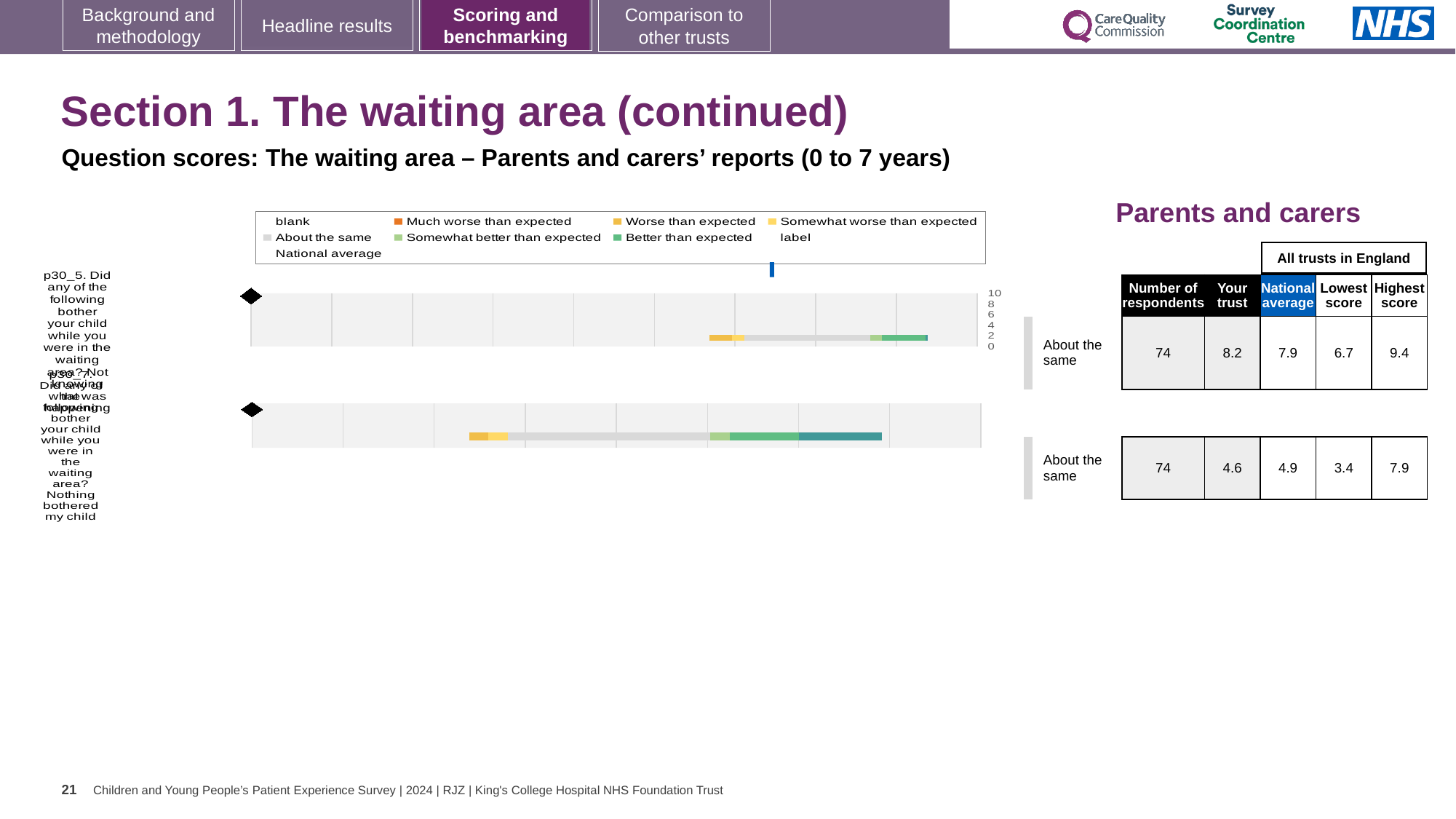
How many respondents are listed for the first question in the table? 74 In the table, what is the 'Your trust' score for the first question (p30_5, Not knowing what was happening)? 8.2 What is the lowest score across all trusts in England for the second question? 3.4 For the first question, which is higher: the 'Your trust' score or the national average? Your trust What is the difference between the highest score and the lowest score for the first question in the table? 2.7 How many entries does the chart legend list? 9 For the second question, which is higher: the 'Your trust' score or the national average? National average How many bars (questions) are plotted in the chart? 2 In the table, what is the national average for the second question (p30_7, Nothing bothered my child)? 4.9 What kind of chart is shown on the slide? Bar chart What colour does the legend use for 'Much worse than expected'? Orange What benchmark category label is shown next to both bars in the chart? About the same